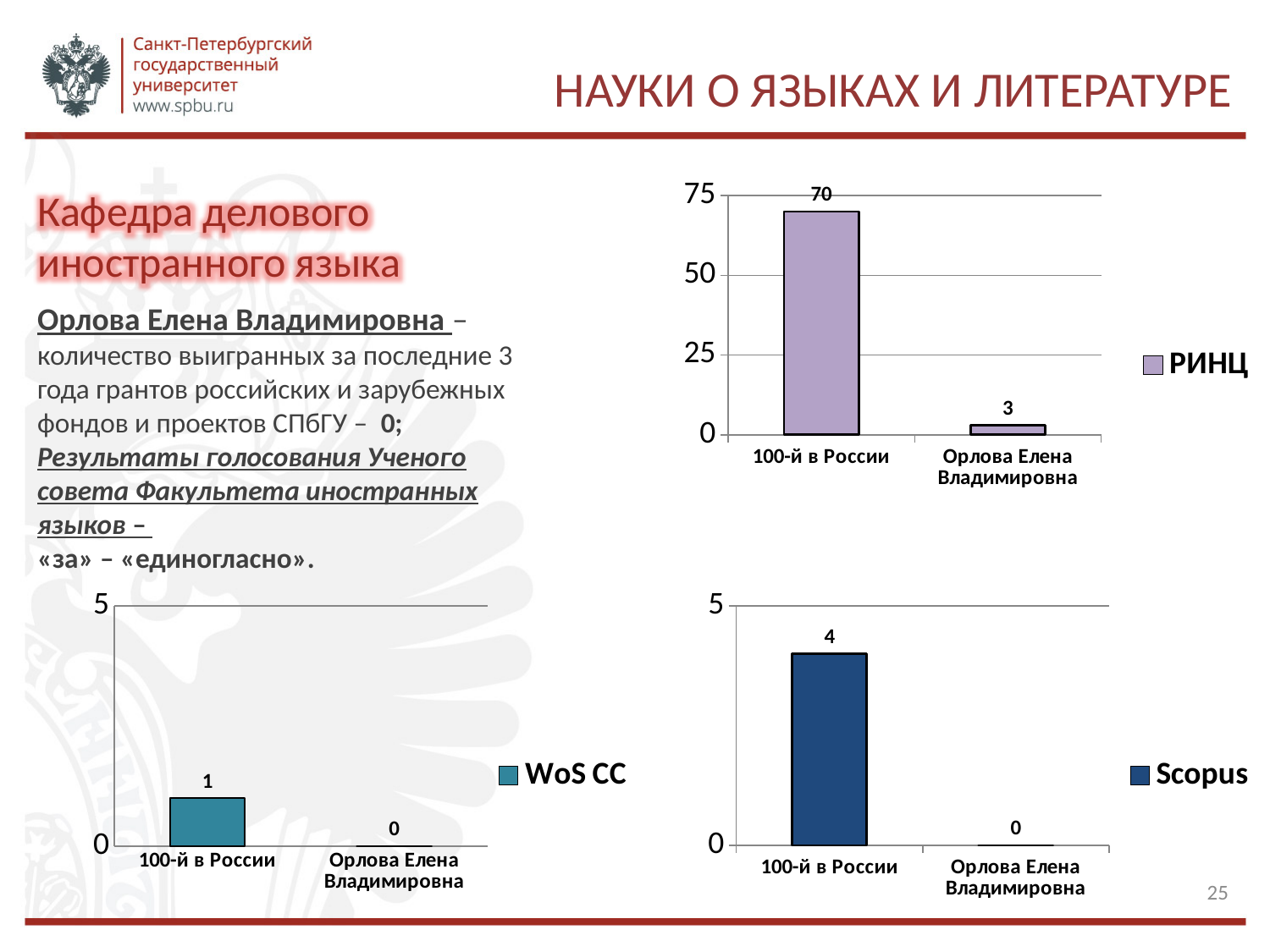
In the Scopus chart, which category has the highest value? 100-й в России How many categories are shown in the WoS CC chart? 2 In the РИНЦ chart, what is the difference between the values for 100-й в России and Орлова Елена Владимировна? 67 In the Scopus chart, what is the value for 100-й в России? 4 In the РИНЦ chart, what is the value for Орлова Елена Владимировна? 3 In the Scopus chart, what is the value for Орлова Елена Владимировна? 0 In the Scopus chart, what is the difference between the values for 100-й в России and Орлова Елена Владимировна? 4 What type of chart is the РИНЦ chart? Bar chart In the WoS CC chart, what is the value for 100-й в России? 1 In the РИНЦ chart, is the value for 100-й в России greater or less than 50? greater In the WoS CC chart, what is the value for Орлова Елена Владимировна? 0 In the РИНЦ chart, what is the value for 100-й в России? 70